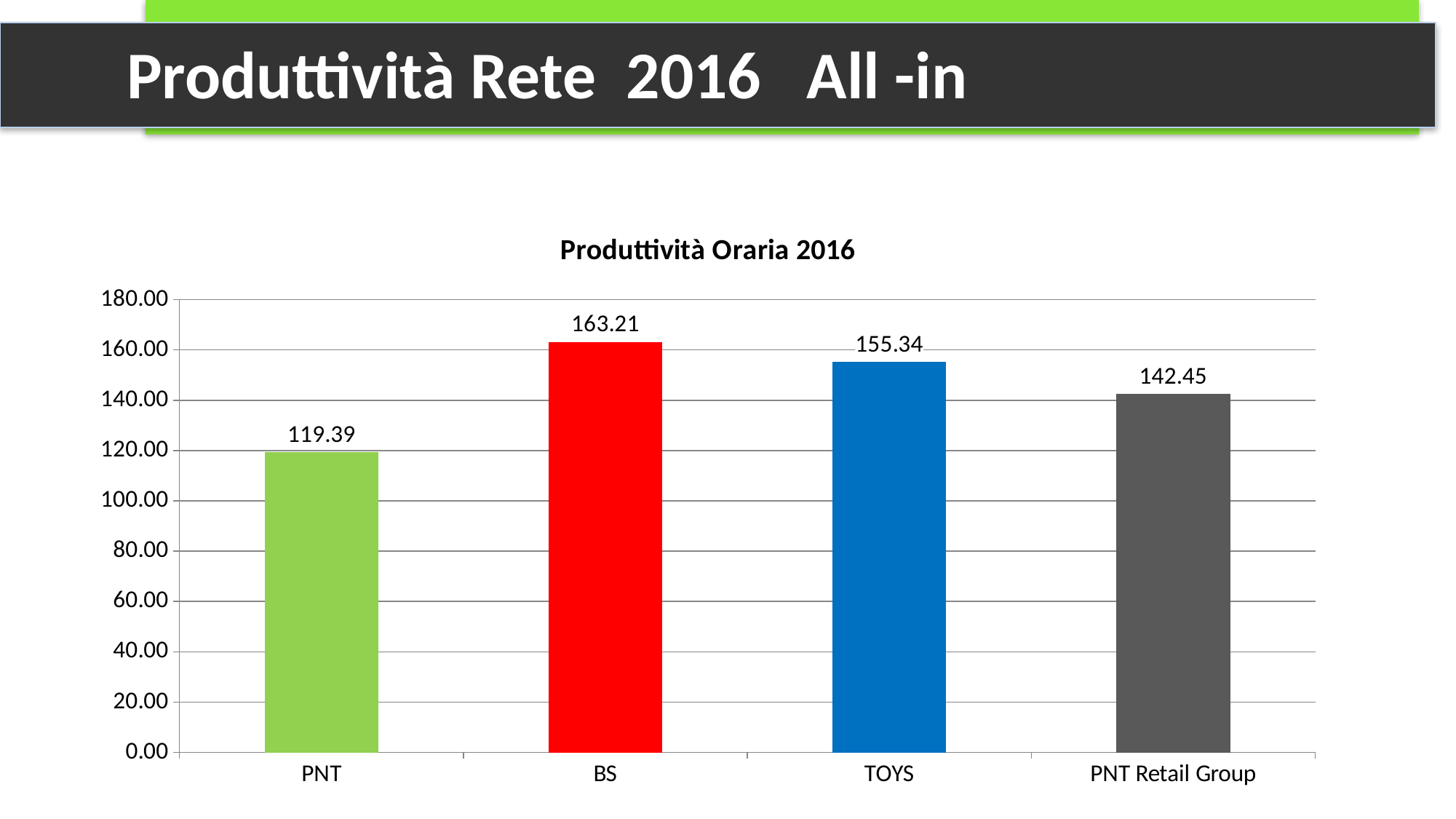
Which category has the highest value? BS What is the value for PNT Retail Group? 142.45 Which is larger, the value for TOYS or the value for PNT Retail Group? TOYS What is the difference between the values for TOYS and PNT Retail Group? 12.89 What is the value for PNT? 119.39 Which category has the lowest value? PNT What kind of chart is shown on the slide? Bar chart What is the title of the chart? Produttività Oraria 2016 What is the value for BS? 163.21 What is the value for TOYS? 155.34 What is the difference between the values for BS and PNT? 43.82 How many categories are shown on the x axis? 4